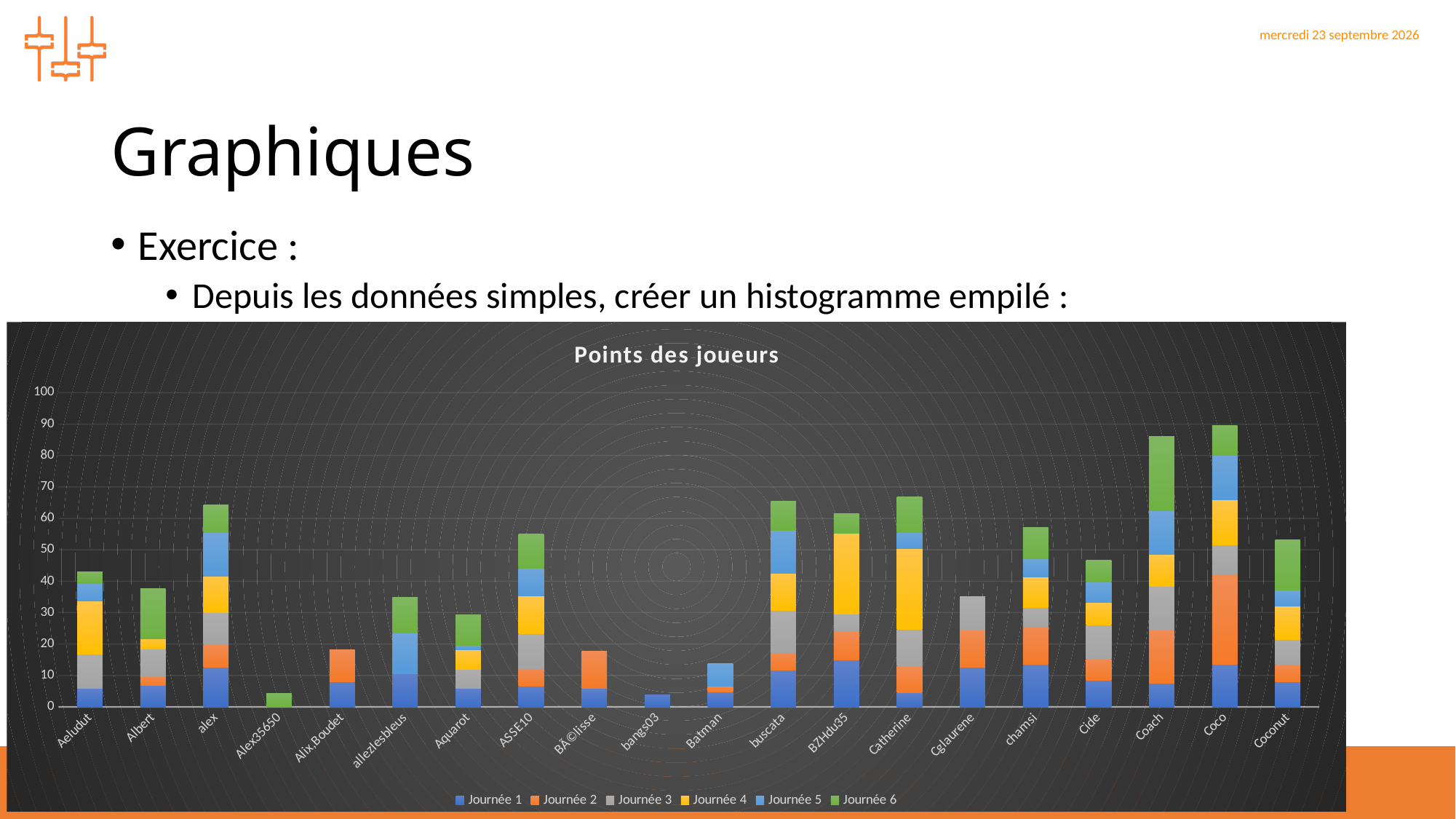
How many series does the legend list? 6 Is the total value for Coach greater or less than 80? greater Is the total value for Aquarot greater or less than 40? less What is the first series listed in the legend? Journée 1 What kind of chart is shown on the slide? Stacked bar chart Which has the larger total bar, alex or Albert? alex Which has the larger total bar, Catherine or Cide? Catherine Which player has the highest total stacked bar? Coco Is the total value for Cglaurene greater or less than 30? greater What is the title of the chart? Points des joueurs How many players (categories) are shown on the x axis? 20